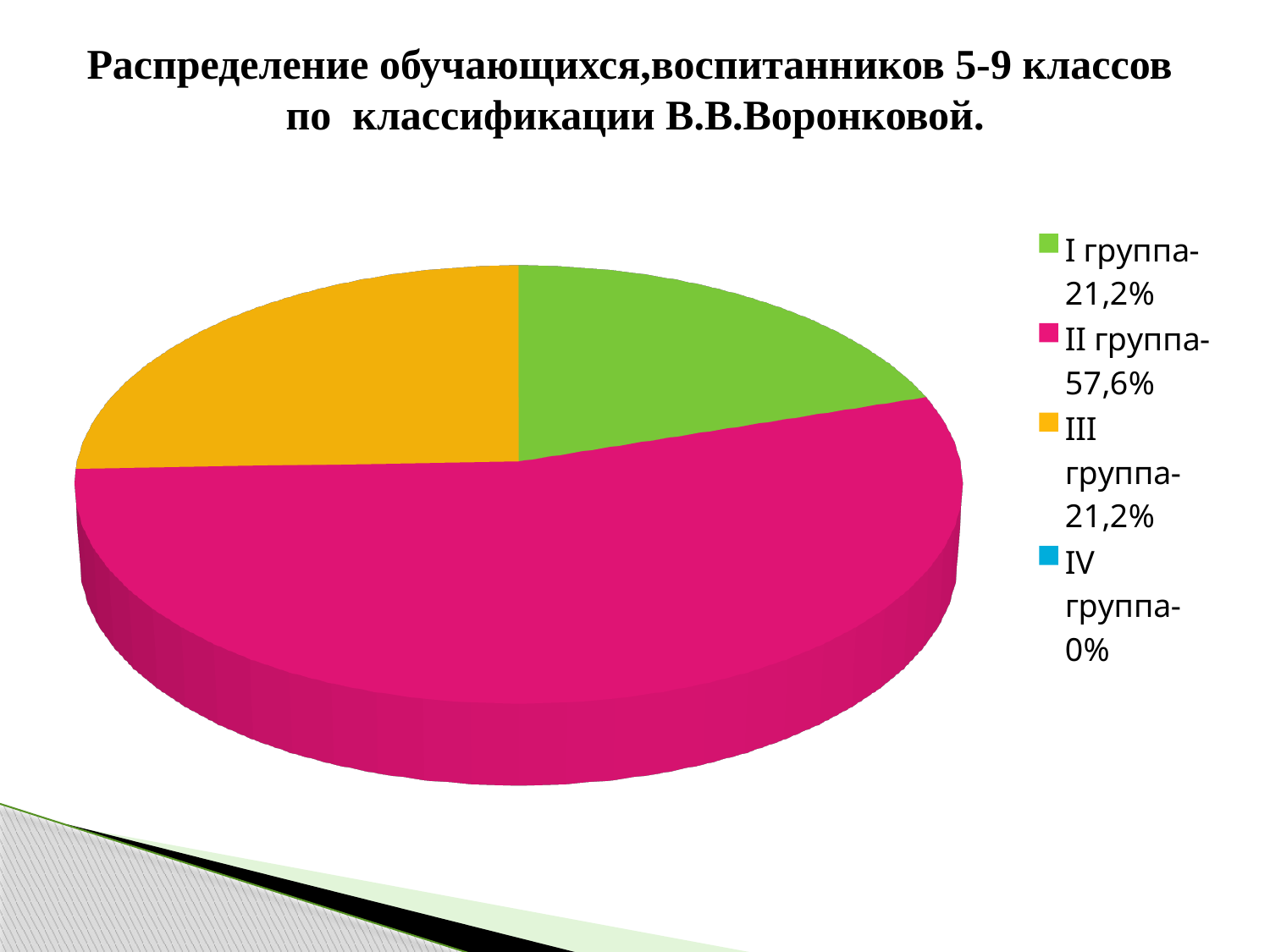
What share of the pie does I группа have? 21,2% What kind of chart is shown on the slide? pie chart Which is larger, the share of II группа or the share of III группа? II группа What colour is the slice for III группа? yellow (orange) What is the difference between the shares of II группа and I группа? 36,4% What share of the pie does II группа have? 57,6% Which group has the largest share of the pie? II группа How many categories does the legend of the pie chart list? 4 What colour is the slice for II группа? pink (magenta) What share of the pie does IV группа have? 0% Which group has the smallest share of the pie? IV группа